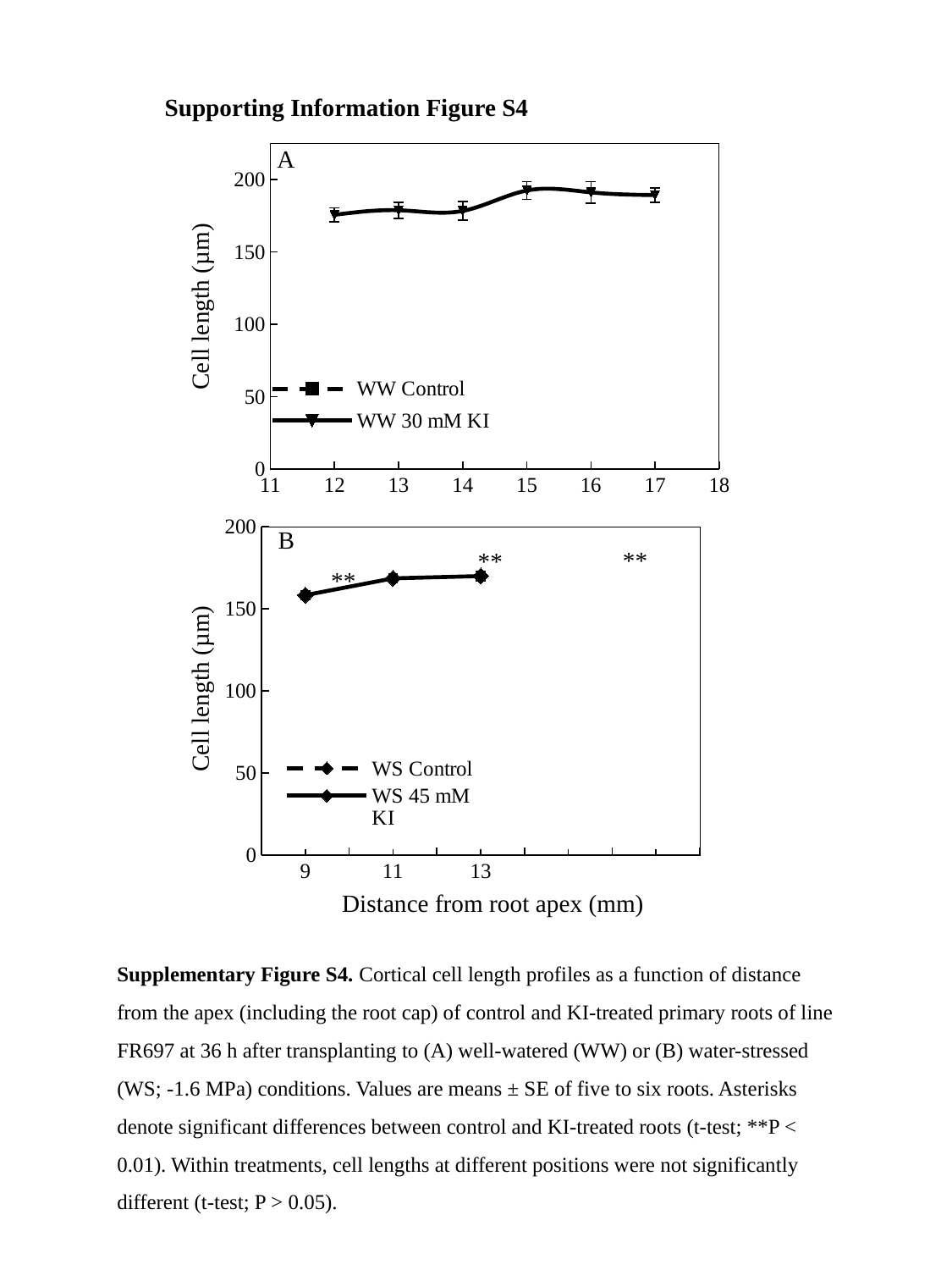
In panel A (the top chart), how many data points are plotted for the WW 30 mM KI series? 6 In panel B (the bottom chart), at which distance from the root apex is the WS 45 mM KI cell length lowest? 9 In panel A (the top chart), is the WW 30 mM KI cell length at 15 mm greater or less than 200? less In panel B (the bottom chart), does the WS 45 mM KI cell length rise or fall from 9 mm to 13 mm? rise In panel B (the bottom chart), is the WS 45 mM KI cell length at 13 mm greater or less than 200? less In panel A (the top chart), is the WW 30 mM KI cell length at 12 mm greater or less than 150? greater How many series does the legend of panel A (the top chart) list? 2 How many series does the legend of panel B (the bottom chart) list? 2 In panel B (the bottom chart), how many data points are plotted for the WS 45 mM KI series? 3 In panel A (the top chart), which is larger for WW 30 mM KI: the cell length at 12 mm or at 15 mm? 15 mm What kind of chart is panel A (the top chart)? line chart